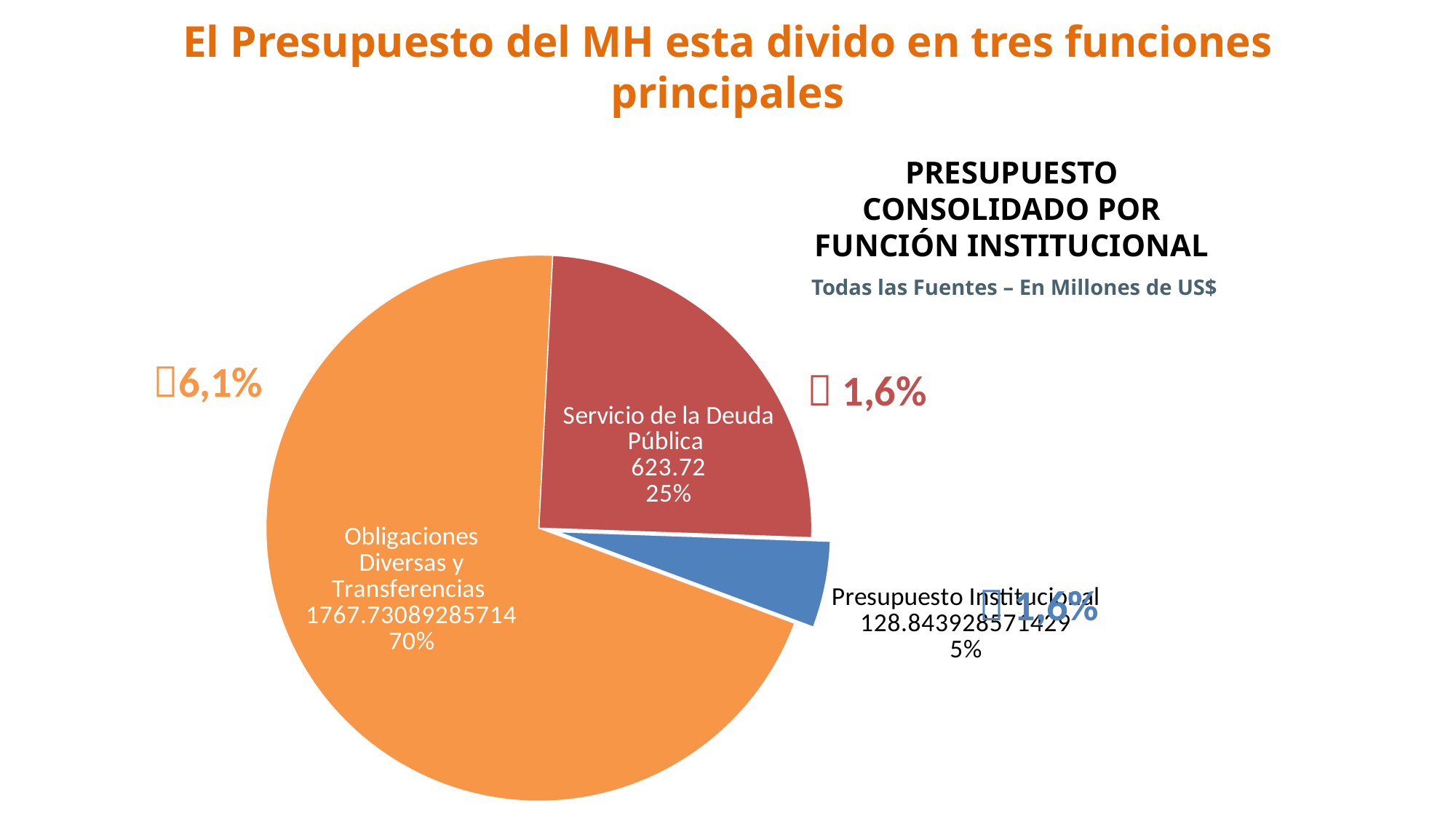
Which is larger, Servicio de la Deuda Pública or Presupuesto Institucional? Servicio de la Deuda Pública Which category has the smallest slice of the pie? Presupuesto Institucional What kind of chart is shown on the slide? Pie chart What is the value shown for Presupuesto Institucional? 128.843928571429 What is the value shown for Servicio de la Deuda Pública? 623.72 What share of the pie does Servicio de la Deuda Pública represent? 25% How many slices does the pie chart have? 3 What share of the pie does Obligaciones Diversas y Transferencias represent? 70% What share of the pie does Presupuesto Institucional represent? 5% What is the value shown for Obligaciones Diversas y Transferencias? 1767.73089285714 What is the title of the pie chart? PRESUPUESTO CONSOLIDADO POR FUNCIÓN INSTITUCIONAL Which category has the largest slice of the pie? Obligaciones Diversas y Transferencias